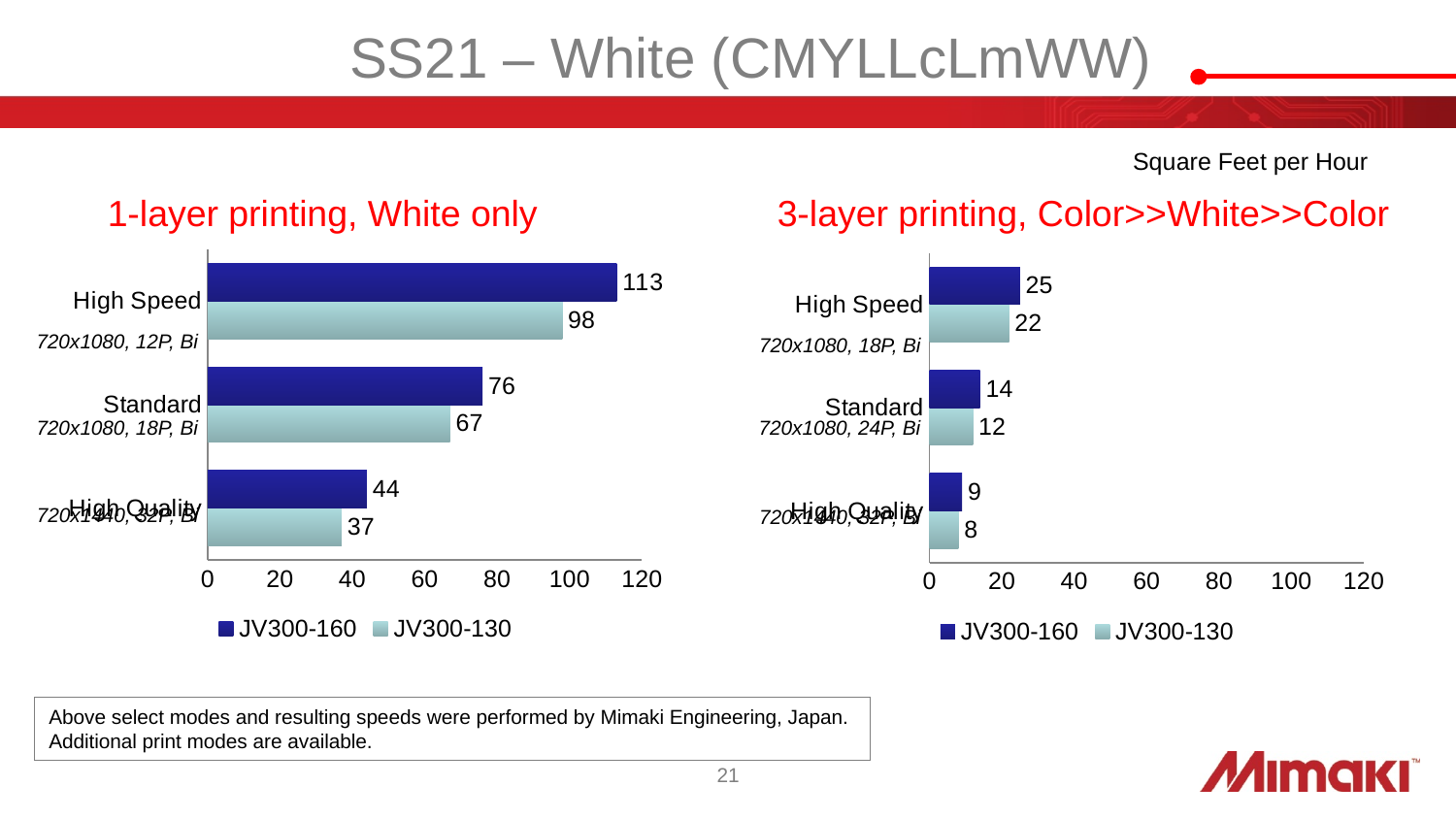
In the '1-layer printing, White only' chart, which is larger at High Quality: JV300-160 or JV300-130? JV300-160 How many print modes are shown in the '3-layer printing, Color>>White>>Color' chart? 3 What kind of chart is the '1-layer printing, White only' chart? Bar chart In the '3-layer printing, Color>>White>>Color' chart, what is the difference between JV300-160 and JV300-130 at Standard? 2 In the '1-layer printing, White only' chart, which print mode has the lowest value for JV300-130? High Quality In the '1-layer printing, White only' chart, what is the value for JV300-160 at High Speed? 113 In the '3-layer printing, Color>>White>>Color' chart, which print mode has the highest value for JV300-160? High Speed In the '1-layer printing, White only' chart, what is the value for JV300-130 at Standard? 67 In the '3-layer printing, Color>>White>>Color' chart, what is the value for JV300-160 at High Quality? 9 In the '3-layer printing, Color>>White>>Color' chart, what is the value for JV300-130 at High Speed? 22 In the '1-layer printing, White only' chart, what is the difference between JV300-160 and JV300-130 at High Speed? 15 How many series does the legend of the '3-layer printing, Color>>White>>Color' chart list? 2